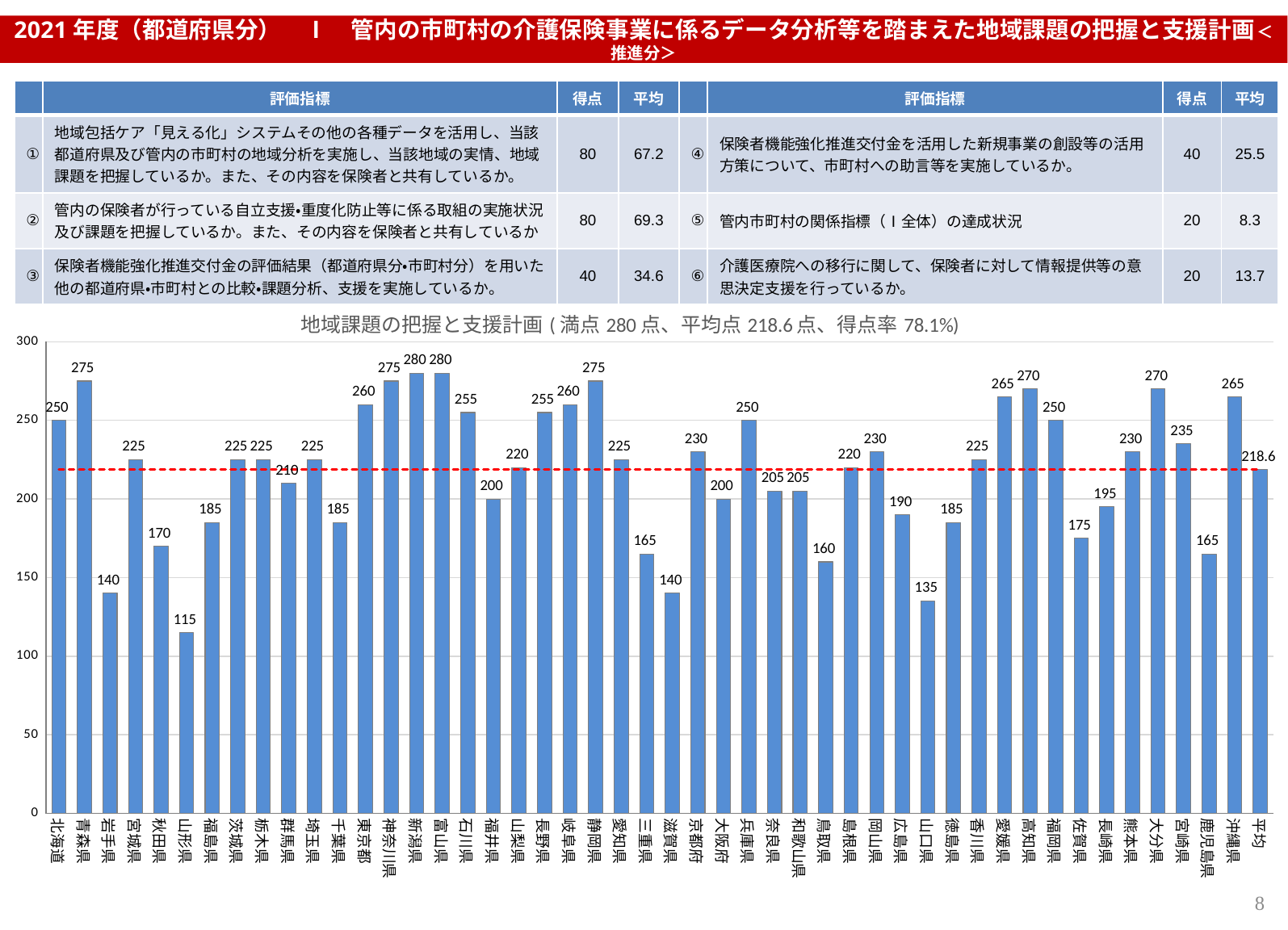
What is the value for 沖縄県 in the bar chart? 265 What is the difference between the values for 青森県 and 岩手県? 135 How many prefectures (excluding the 平均 bar) are plotted in the bar chart? 47 What is the difference between the values for 高知県 and 佐賀県? 95 Which prefectures have the highest value (280) in the bar chart? 新潟県 and 富山県 What is the value for 山口県 in the bar chart? 135 What kind of chart is shown on the slide? bar chart Which prefecture has the lowest value in the bar chart? 山形県 Is the value for 鳥取県 greater or less than 150? greater What is the value for 北海道 in the bar chart? 250 Which has a larger value, 東京都 or 大阪府? 東京都 What value does the red dashed horizontal line in the chart represent? 218.6